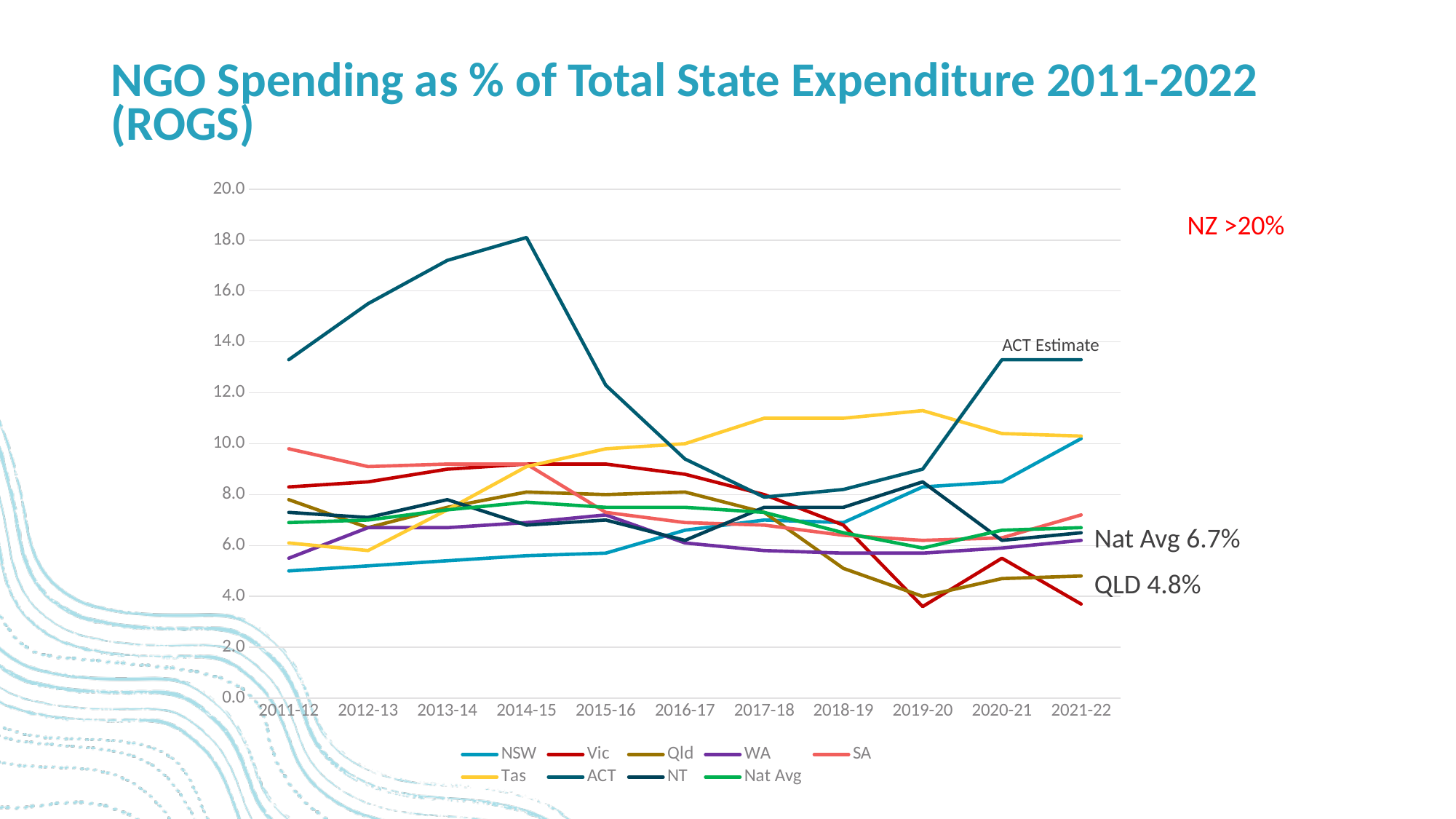
Is the value for Vic in 2021-22 greater or less than 4.0? less Is the value for ACT in 2014-15 greater or less than 16.0? greater What is the QLD value labelled at the end of the chart? 4.8% How many financial years are shown along the x axis? 11 How many series does the legend list? 9 What value does the red annotation give for NZ? >20% What is the Nat Avg value labelled at the end of the chart? 6.7% Which series has the highest value in 2011-12? ACT In 2017-18, which is larger, Tas or ACT? Tas What kind of chart is shown on the slide? line chart Which series has the lowest value in 2021-22? Vic Does the NSW line rise or fall from 2011-12 to 2021-22? rise